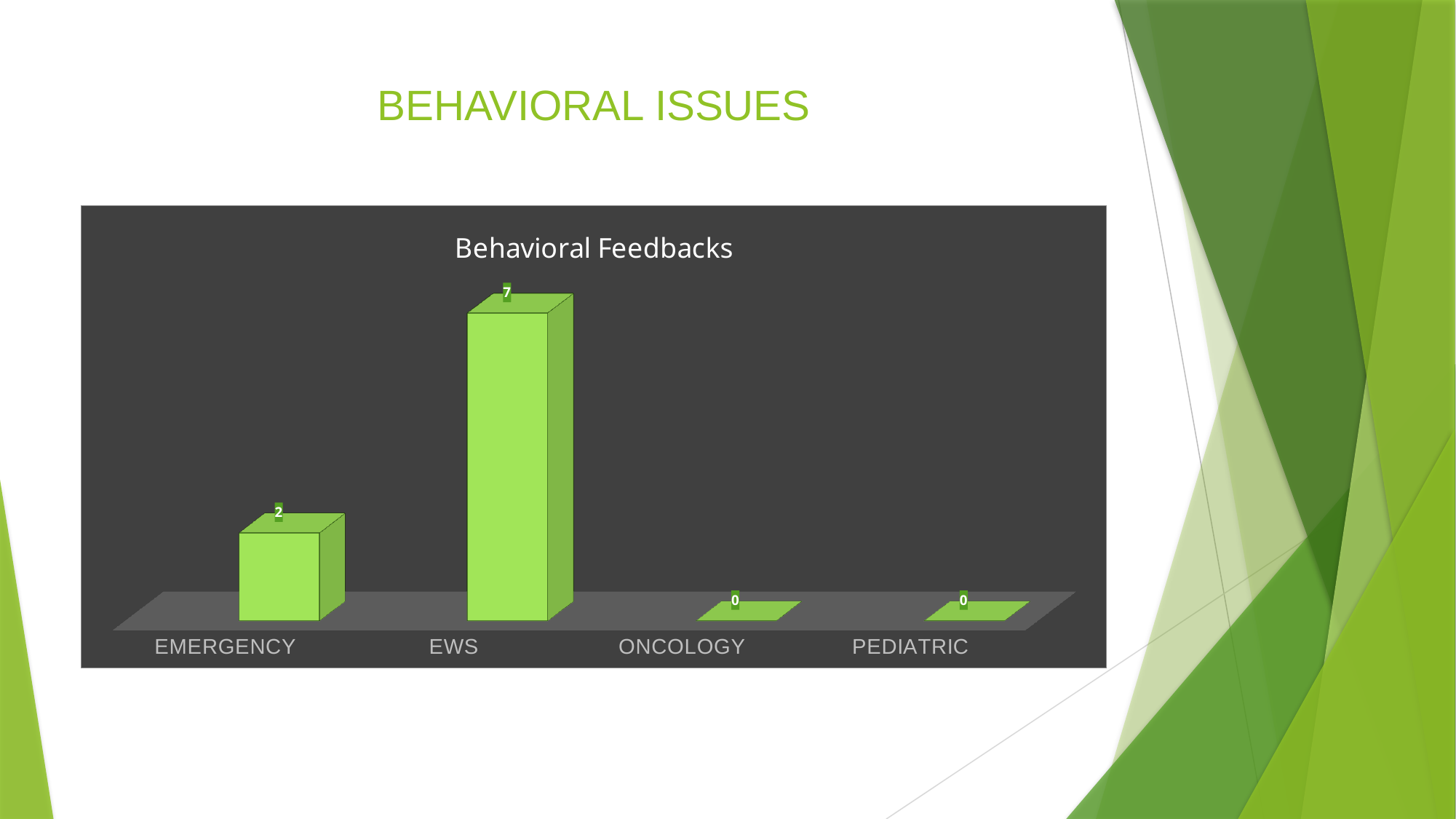
How many categories in the Behavioral Feedbacks chart have a value of 0? 2 What is the value for EWS in the Behavioral Feedbacks chart? 7 Which category has the highest value in the Behavioral Feedbacks chart? EWS What is the value for EMERGENCY in the Behavioral Feedbacks chart? 2 What is the title of the chart on the slide? Behavioral Feedbacks What is the value for PEDIATRIC in the Behavioral Feedbacks chart? 0 Which is larger, the value for EMERGENCY or the value for EWS? EWS What is the total of the values for EMERGENCY and EWS? 9 How many categories are shown on the x axis of the Behavioral Feedbacks chart? 4 What is the difference between the values for EWS and EMERGENCY? 5 What is the value for ONCOLOGY in the Behavioral Feedbacks chart? 0 What kind of chart is shown on the slide? Bar chart